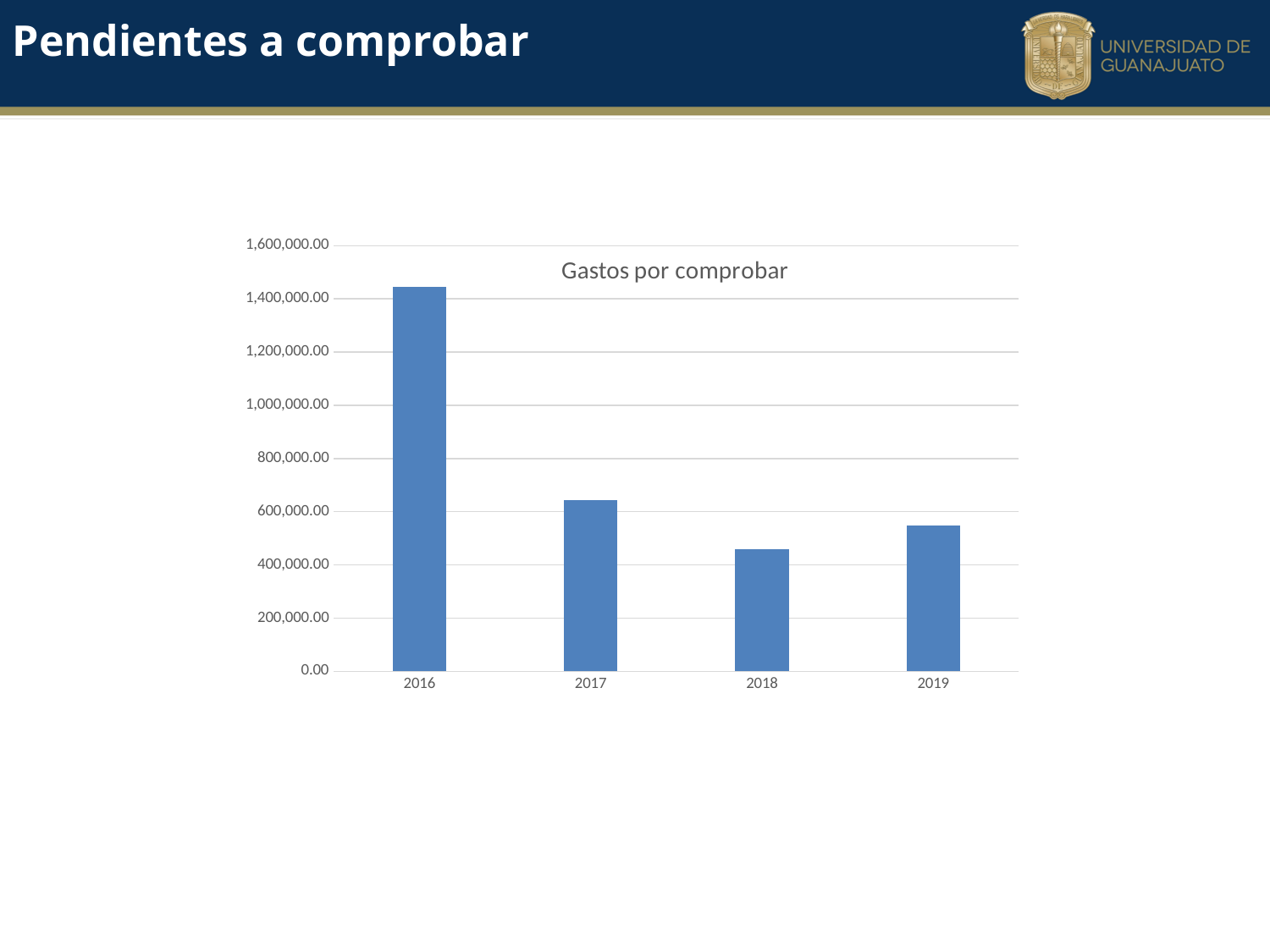
What is the title of the chart? Gastos por comprobar Which is larger, the value for 2018 or the value for 2019? 2019 What kind of chart is shown on the slide? bar chart Is the value for 2018 greater or less than 600,000.00? less Which year has the lowest value in the chart? 2018 Is the value for 2016 greater or less than 1,200,000.00? greater Is the value for 2017 greater or less than 600,000.00? greater Which year has the highest value in the chart? 2016 Which is larger, the value for 2017 or the value for 2019? 2017 Do the values rise or fall from 2016 to 2018? fall How many years are shown on the x axis of the chart? 4